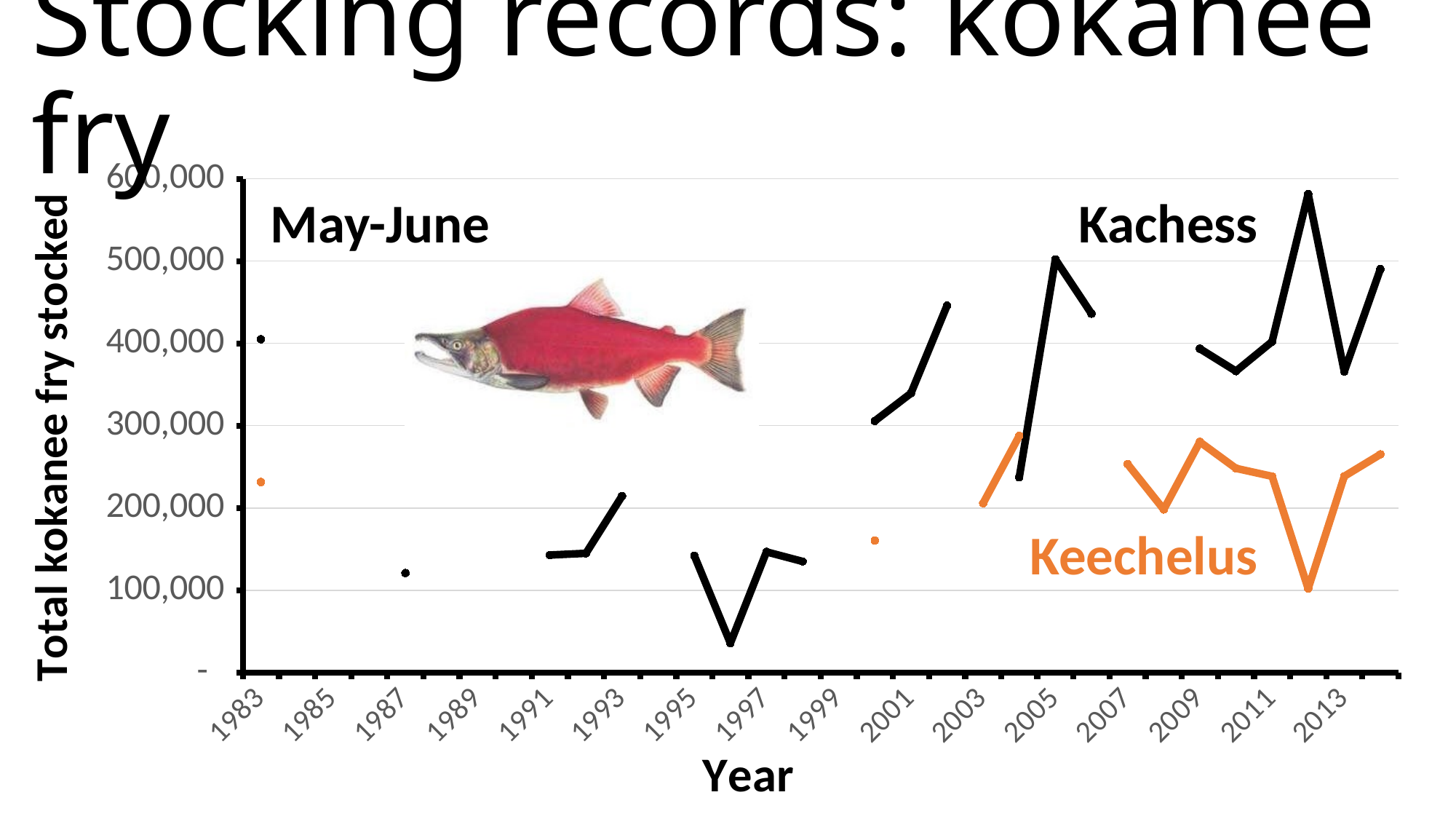
Is the Keechelus value for 2004 greater or less than 200,000? greater What kind of chart is shown on the slide? line chart What is the title of the vertical axis? Total kokanee fry stocked Is the Kachess value for 2002 greater or less than 400,000? greater What colour is the Keechelus series drawn in? orange Is the Kachess value for 1983 greater or less than 300,000? greater Which series reaches the highest value on the chart? Kachess In 2012, which series has the higher value, Kachess or Keechelus? Kachess How many data series are plotted on the chart? 2